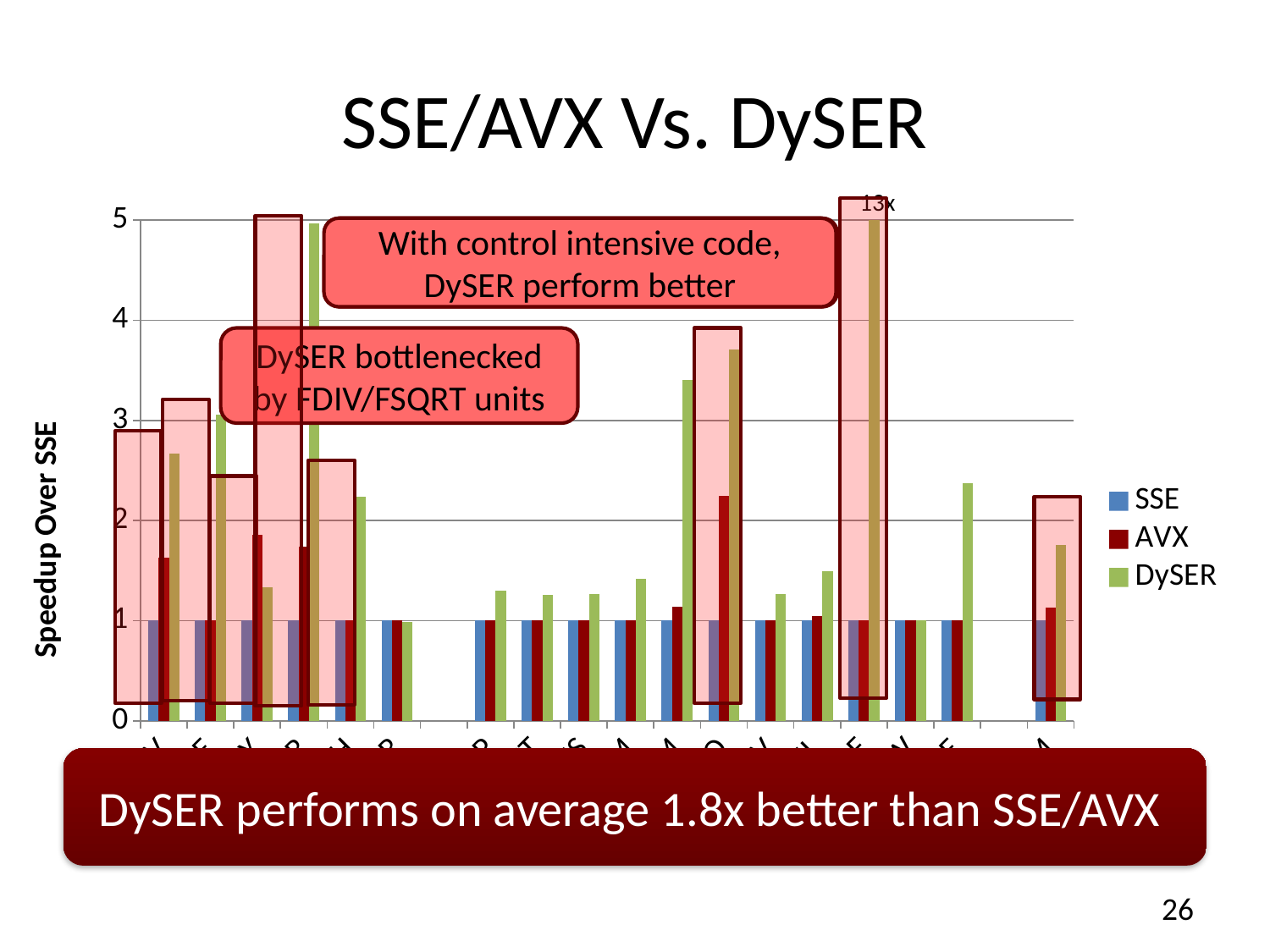
What kind of chart is shown on the slide? bar chart Which series is plotted in green? DySER What value is printed on the DySER bar that extends above the top of the chart? 13x In the group containing the bar labeled 13x, which series has the highest value? DySER What is the label on the vertical axis of the chart? Speedup Over SSE What are the three series named in the chart legend? SSE, AVX, DySER How many series does the chart legend list? 3 What value do the SSE bars take across the categories? 1 Is the DySER bar labeled 13x greater or less than 5? greater